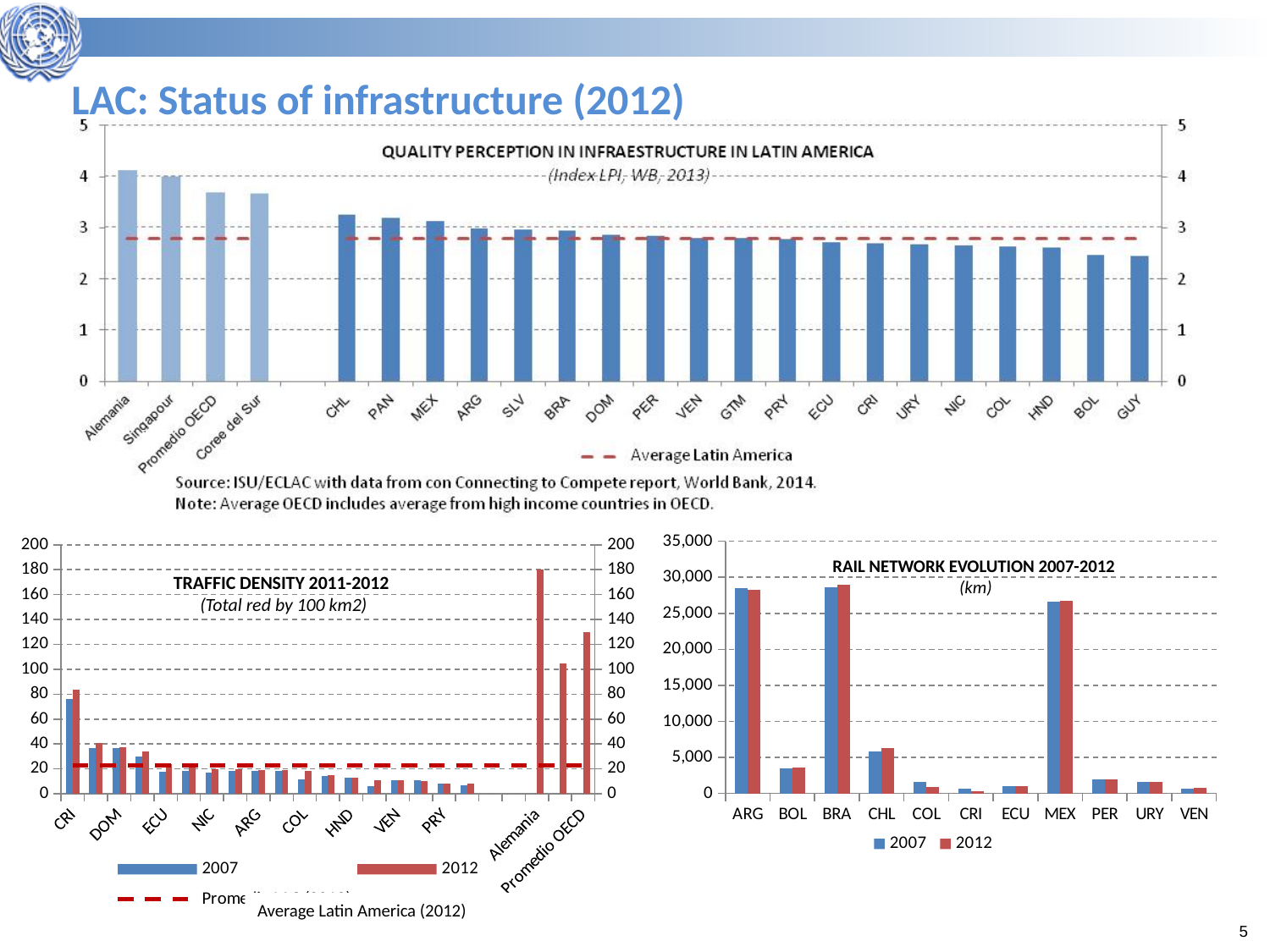
In the 'TRAFFIC DENSITY 2011-2012' chart, is the 2012 value for Promedio OECD greater or less than 120? greater In the 'RAIL NETWORK EVOLUTION 2007-2012' chart, is the 2012 value for CHL greater or less than 5,000? greater How many countries are shown on the x axis of the 'RAIL NETWORK EVOLUTION 2007-2012' chart? 11 In the 'TRAFFIC DENSITY 2011-2012' chart, which category has the highest 2012 value? Alemania In the 'RAIL NETWORK EVOLUTION 2007-2012' chart, which is larger in 2012: MEX or CHL? MEX In the 'QUALITY PERCEPTION IN INFRAESTRUCTURE IN LATIN AMERICA' chart, which category has the highest value? Alemania In the 'RAIL NETWORK EVOLUTION 2007-2012' chart, is the 2007 value for ARG greater or less than 25,000? greater What kind of chart is the 'RAIL NETWORK EVOLUTION 2007-2012' chart? bar chart How many series does the legend of the 'RAIL NETWORK EVOLUTION 2007-2012' chart list? 2 In the 'QUALITY PERCEPTION IN INFRAESTRUCTURE IN LATIN AMERICA' chart, which category has the lowest value? GUY